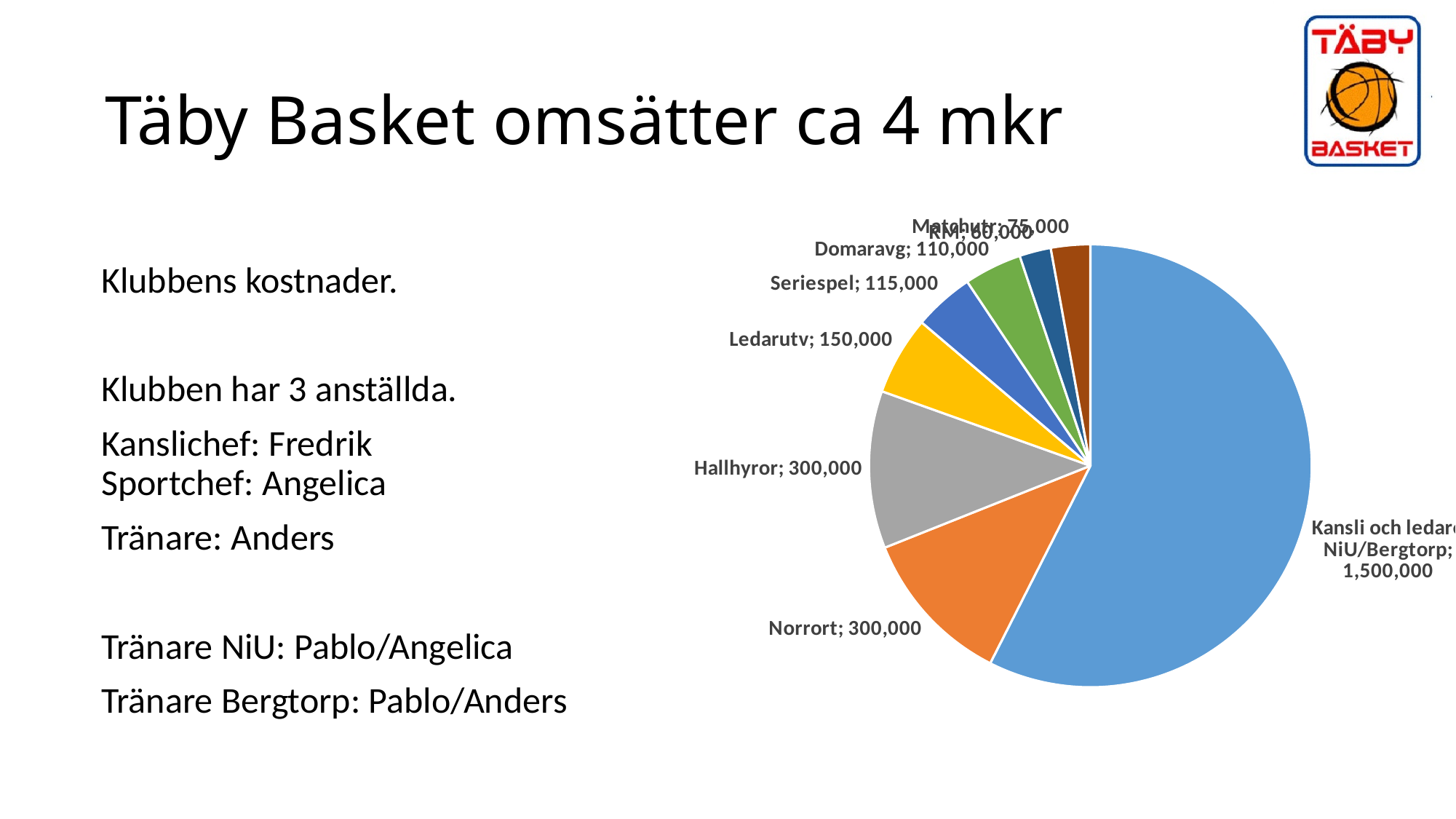
What is the value for Domaravg in the pie chart? 110,000 Which category has the largest slice in the pie chart? Kansli och ledare NiU/Bergtorp Which is larger, the value for Ledarutv or the value for Seriespel? Ledarutv What is the value for Seriespel in the pie chart? 115,000 What is the value for Hallhyror in the pie chart? 300,000 How many slices does the pie chart have? 8 What is the difference between the value for Kansli och ledare NiU/Bergtorp and the value for Norrort? 1,200,000 Which category has the smallest slice in the pie chart? RM What kind of chart is shown on the slide? Pie chart What is the value for Ledarutv in the pie chart? 150,000 What is the value for RM in the pie chart? 60,000 What is the value for Norrort in the pie chart? 300,000